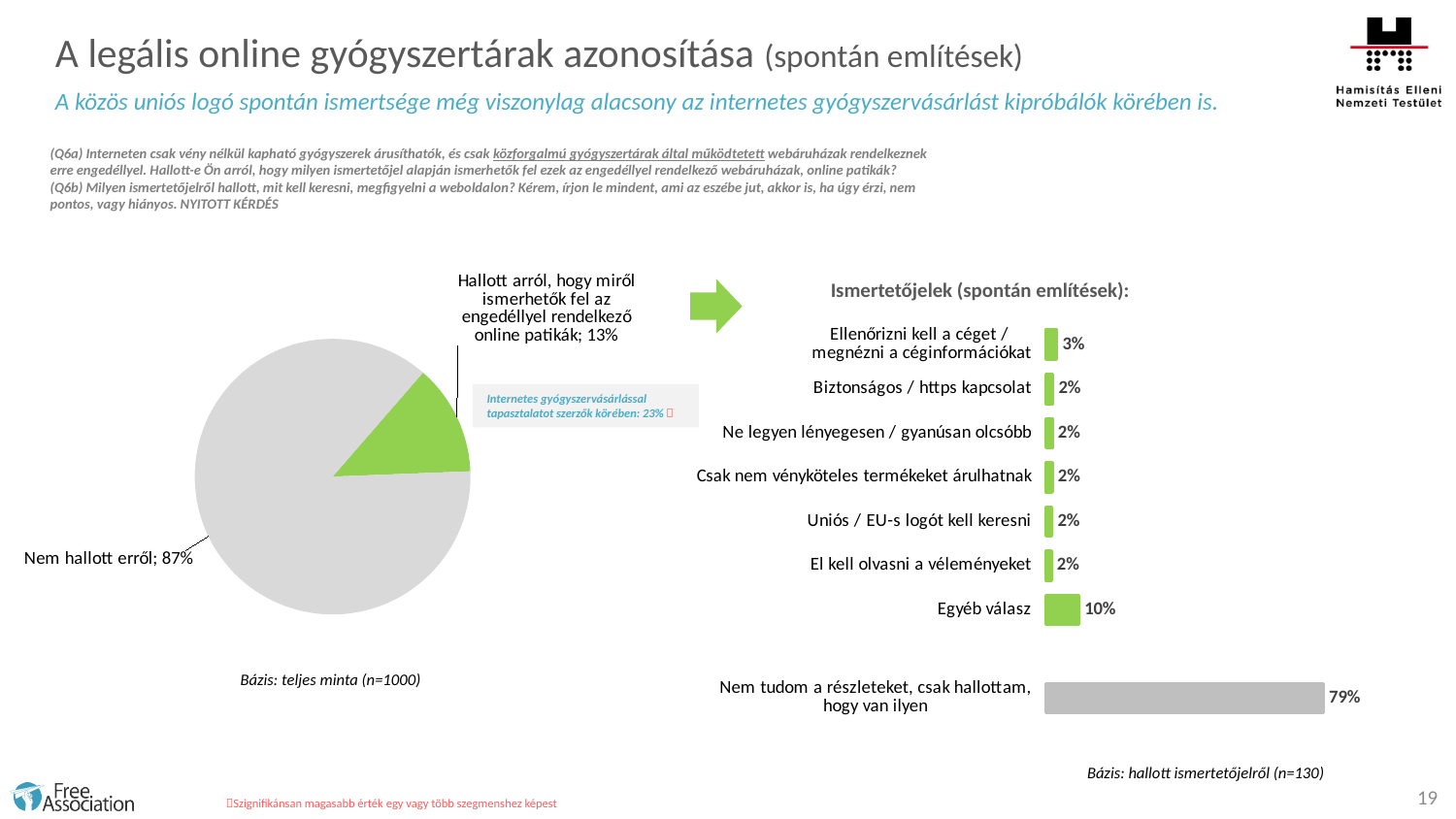
What type of chart is shown on the left side of the slide? pie chart In the "Ismertetőjelek (spontán említések)" chart, what is the value for "Nem tudom a részleteket, csak hallottam, hogy van ilyen"? 79% In the pie chart on the left, what share is labelled "Nem hallott erről"? 87% How many slices does the pie chart on the left have? 2 In the "Ismertetőjelek (spontán említések)" chart, what is the value for "Ellenőrizni kell a céget / megnézni a céginformációkat"? 3% In the "Ismertetőjelek (spontán említések)" chart, which is larger: "Egyéb válasz" or "Uniós / EU-s logót kell keresni"? Egyéb válasz In the pie chart on the left, what is the difference between the "Nem hallott erről" share and the "Hallott arról" share? 74% In the "Ismertetőjelek (spontán említések)" chart, what is the value for "Egyéb válasz"? 10% What type of chart is "Ismertetőjelek (spontán említések)" on the right? bar chart In the "Ismertetőjelek (spontán említések)" chart, how many categories are shown? 8 In the "Ismertetőjelek (spontán említések)" chart, which category has the highest value? Nem tudom a részleteket, csak hallottam, hogy van ilyen In the pie chart on the left, what share of respondents heard about how licensed online pharmacies can be recognised ("Hallott arról...")? 13%